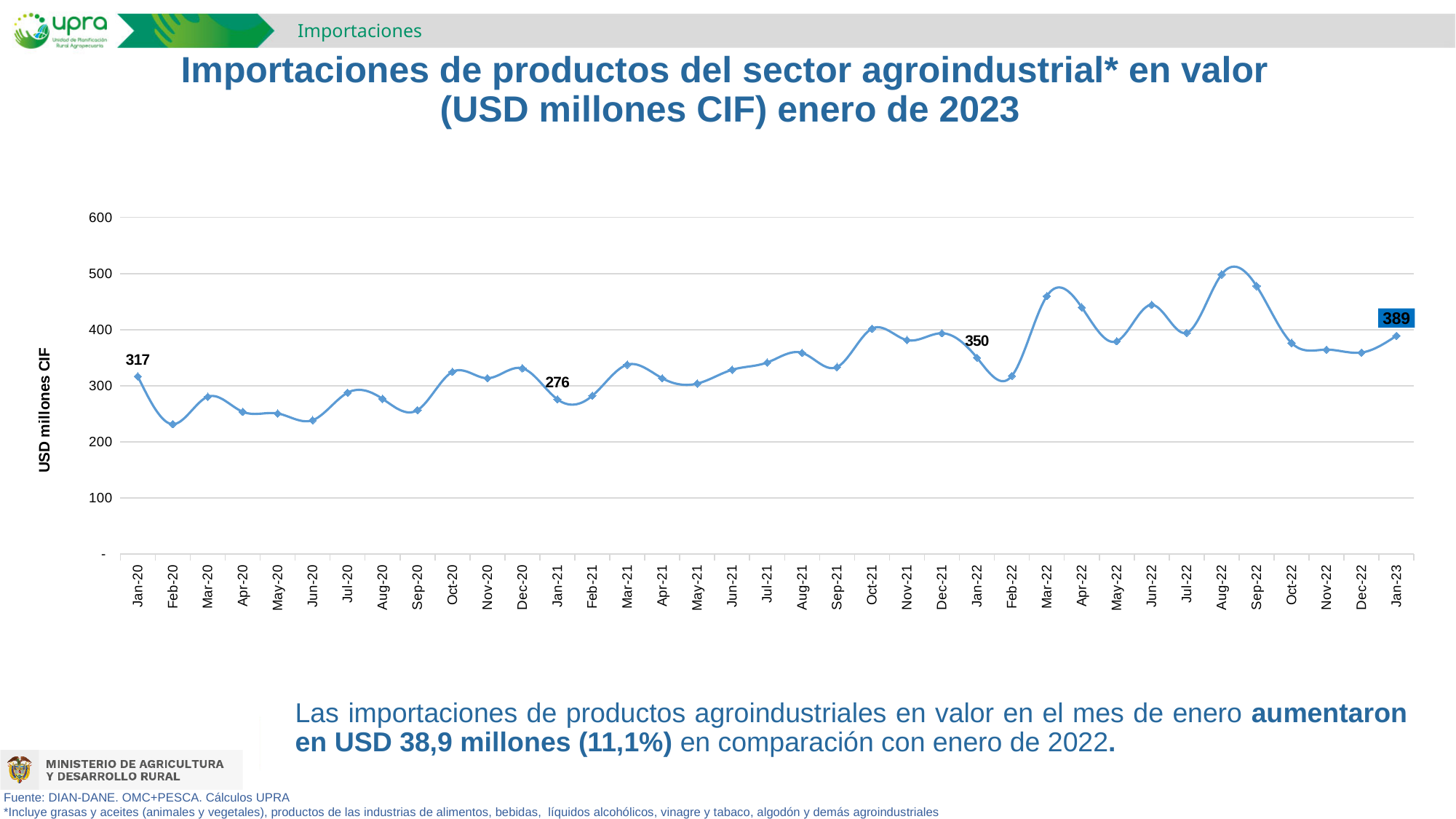
What is the difference between the values for Jan-22 and Jan-21? 74 How many monthly data points are plotted on the chart? 37 Which is larger, the value for Jan-23 or the value for Jan-20? Jan-23 What type of chart is shown on the slide? Line chart Which month has the highest value on the chart? Aug-22 Which month has the lowest value on the chart? Feb-20 What is the value of imports for Jan-23? 389 Is the value for Aug-22 greater or less than 400? greater What is the value of imports for Jan-22? 350 What is the value of imports for Jan-21? 276 What is the value of imports for Jan-20? 317 What is the difference between the values for Jan-23 and Jan-22? 39